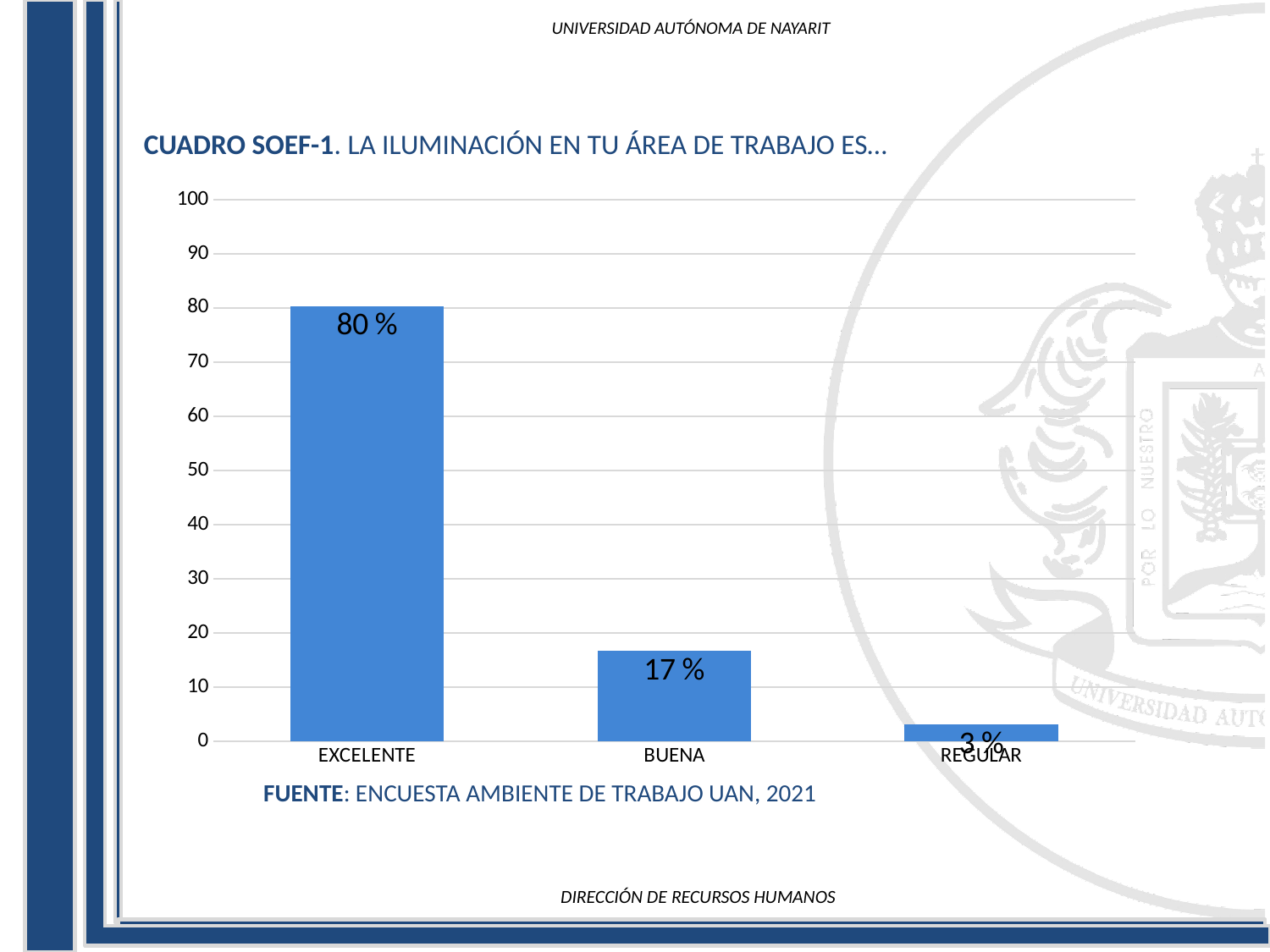
What is the difference between the values for EXCELENTE and BUENA? 63 % What is the source cited below the chart? ENCUESTA AMBIENTE DE TRABAJO UAN, 2021 How many categories are shown on the x axis? 3 What kind of chart is shown on the slide? bar chart What is the value for REGULAR? 3 % Is the value for BUENA greater or less than 20? less What is the difference between the values for BUENA and REGULAR? 14 % Which category has the lowest value? REGULAR Which category has the highest value? EXCELENTE What is the value for EXCELENTE? 80 % Which is larger, the value for BUENA or the value for REGULAR? BUENA What is the value for BUENA? 17 %